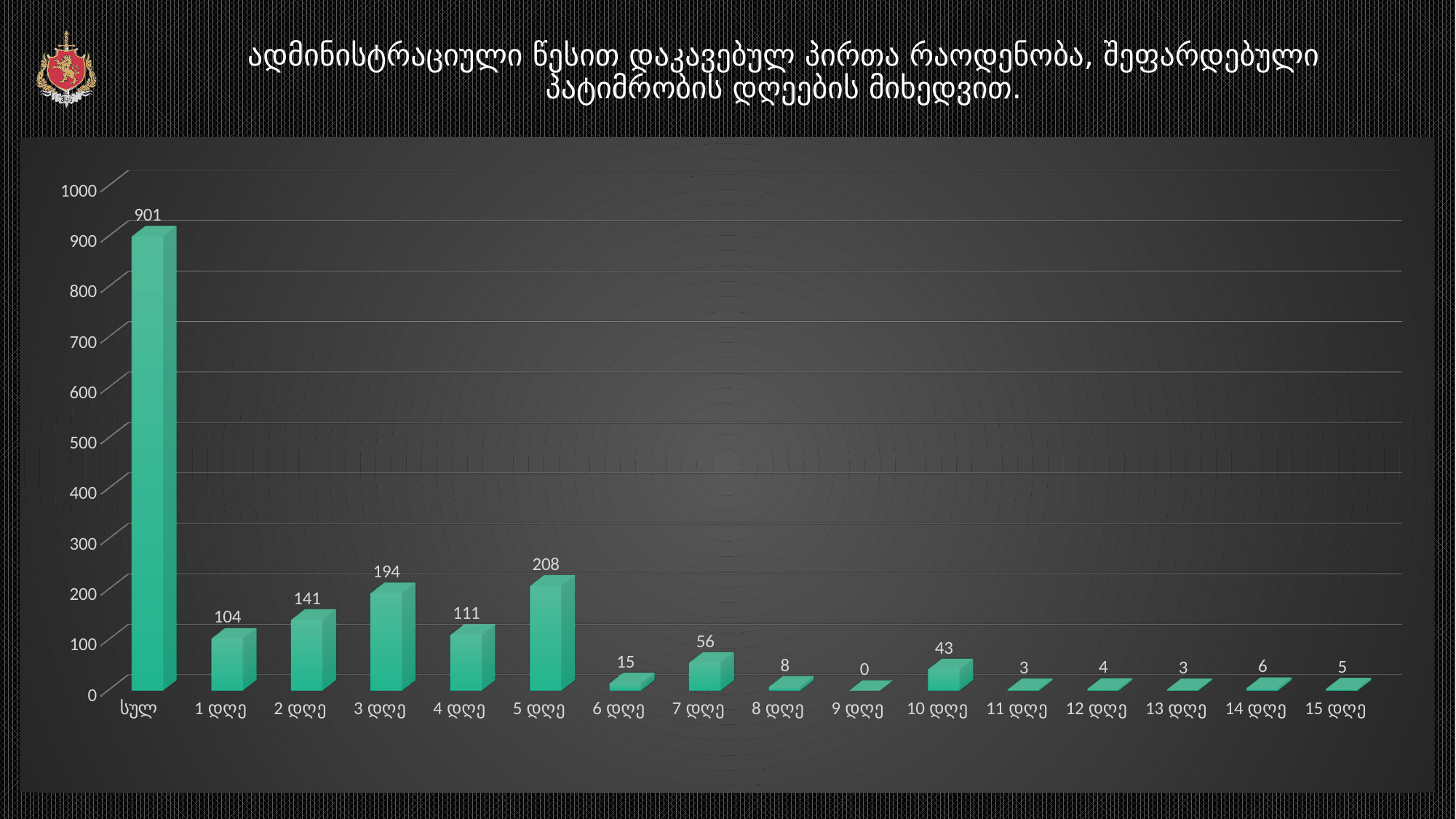
Excluding the "სულ" bar, which day category has the highest value? 5 დღე What is the difference between the values for "5 დღე" and "3 დღე"? 14 What is the difference between the values for "7 დღე" and "6 დღე"? 41 Which is larger, the value for "2 დღე" or the value for "4 დღე"? 2 დღე How many categories are shown on the x axis? 16 What is the value for "5 დღე"? 208 What is the value for "9 დღე"? 0 What is the value for the bar labelled "სულ"? 901 Is the value for "სულ" greater or less than 900? greater What is the value for "10 დღე"? 43 What kind of chart is shown on the slide? bar chart Which category has the lowest value? 9 დღე